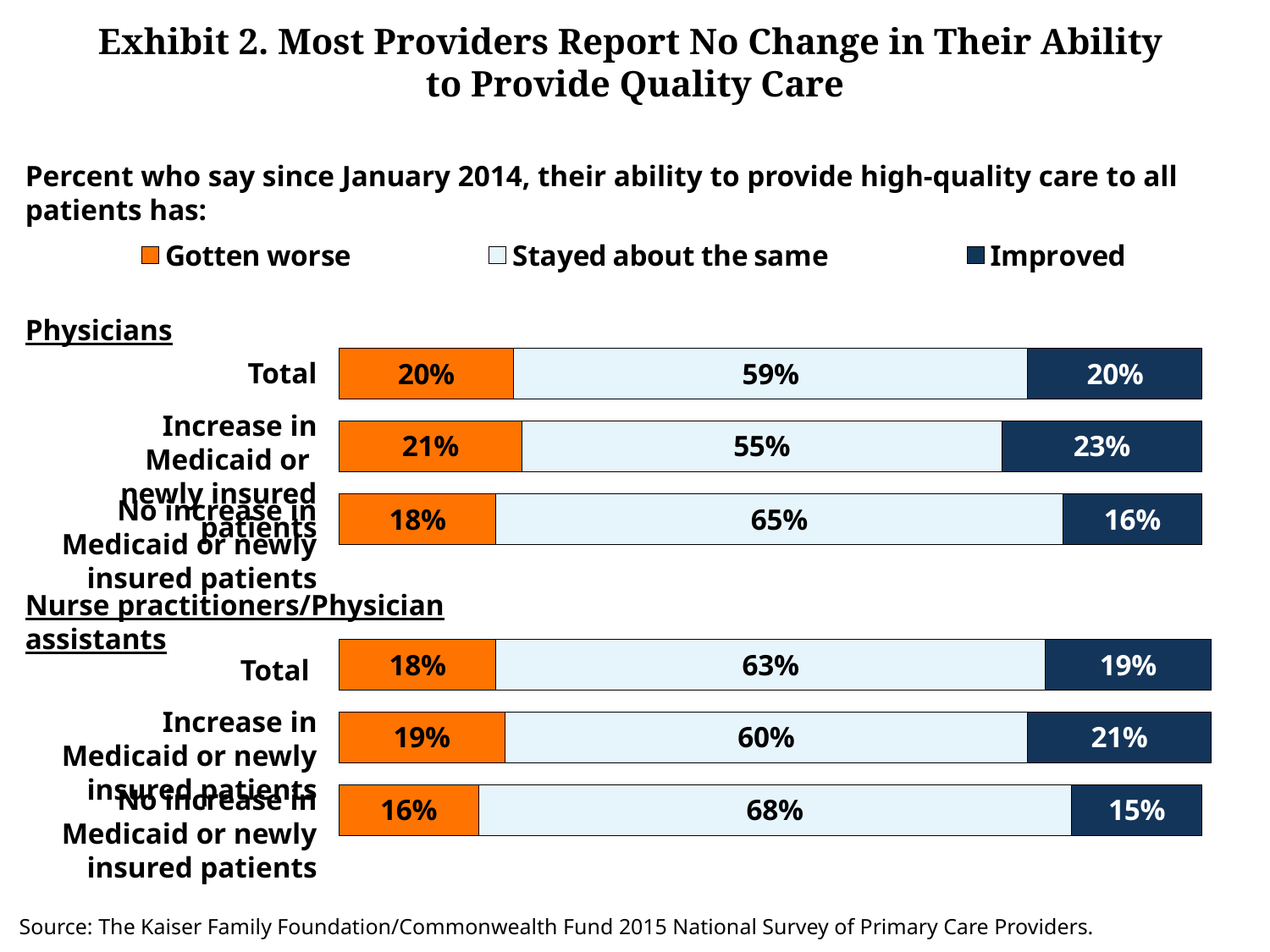
How many groups (bars) are shown in the Physicians chart? 3 How many series does the legend list? 3 In the Physicians chart, what is the difference between the 'Stayed about the same' share for the No increase group and the Increase group? 10 percentage points Which legend entry is shown in orange? Gotten worse In the Nurse practitioners/Physician assistants chart, what percent of the Total group say their ability has gotten worse? 18% In the Nurse practitioners/Physician assistants chart, is the 'Improved' share larger for the Total group or the Increase in Medicaid or newly insured patients group? Increase in Medicaid or newly insured patients In the Nurse practitioners/Physician assistants chart, what percent of those with no increase in Medicaid or newly insured patients say their ability has stayed about the same? 68% In the Physicians chart, what percent of physicians with an increase in Medicaid or newly insured patients say their ability has improved? 23% In the Nurse practitioners/Physician assistants chart, which group has the lowest share saying their ability has improved? No increase in Medicaid or newly insured patients In the Physicians chart, what percent of the Total group say their ability to provide high-quality care has stayed about the same? 59% In the Physicians chart, which group has the highest share saying their ability has stayed about the same? No increase in Medicaid or newly insured patients What kind of chart is used on this slide? Stacked bar chart